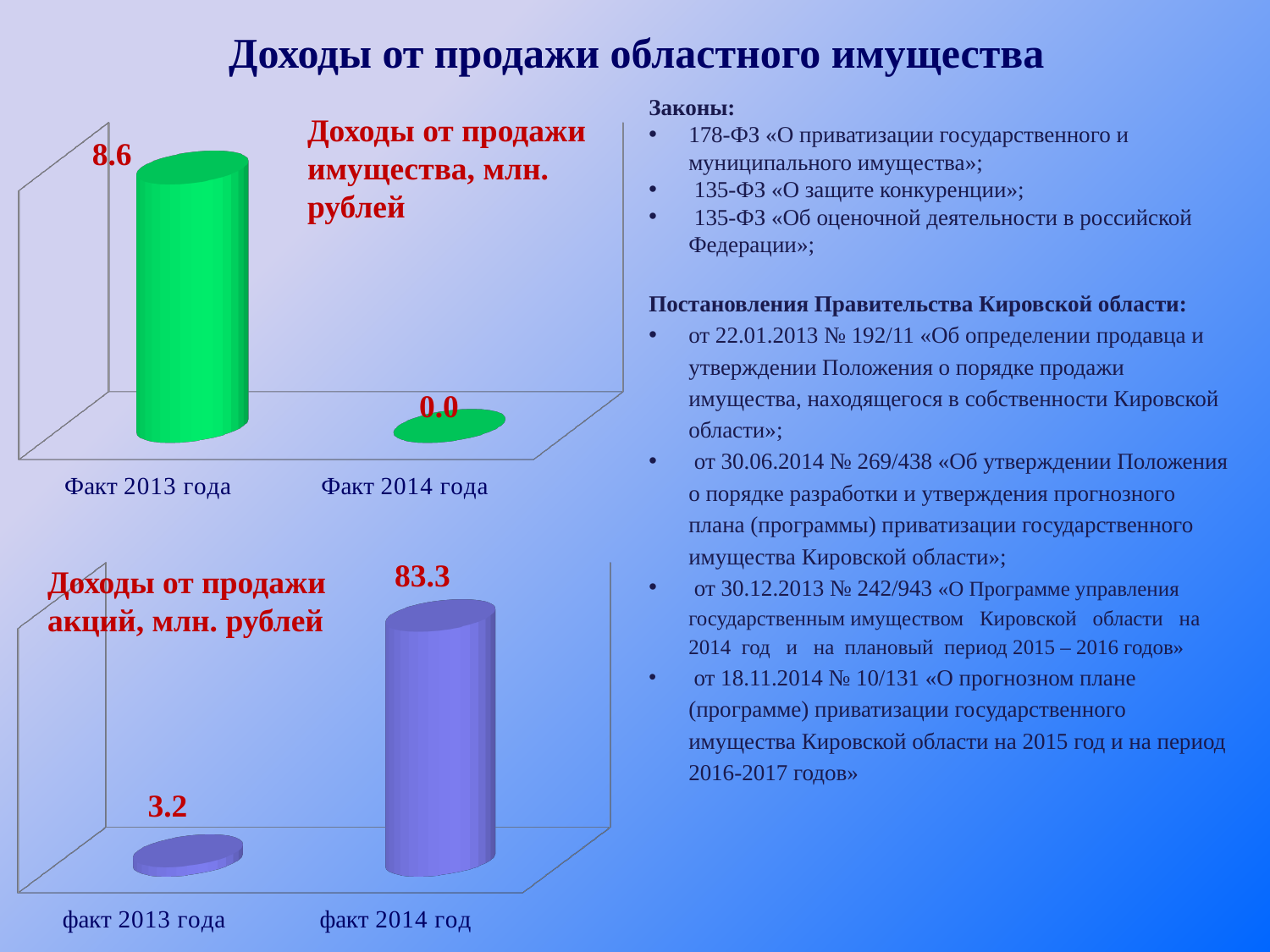
In the chart 'Доходы от продажи имущества, млн. рублей', what is the value for Факт 2014 года? 0.0 In the chart 'Доходы от продажи имущества, млн. рублей', which category has the highest value? Факт 2013 года In the chart 'Доходы от продажи имущества, млн. рублей', what is the value for Факт 2013 года? 8.6 In the chart 'Доходы от продажи акций, млн. рублей', do the values rise or fall from факт 2013 года to факт 2014 год? Rise What kind of chart is the bottom chart 'Доходы от продажи акций, млн. рублей'? Bar chart In the chart 'Доходы от продажи акций, млн. рублей', what is the value for факт 2013 года? 3.2 In the chart 'Доходы от продажи акций, млн. рублей', what is the difference between the values for факт 2014 год and факт 2013 года? 80.1 In the chart 'Доходы от продажи акций, млн. рублей', which is larger: the value for факт 2013 года or факт 2014 год? факт 2014 год In the chart 'Доходы от продажи акций, млн. рублей', which category has the lowest value? факт 2013 года How many categories are shown in the chart 'Доходы от продажи имущества, млн. рублей'? 2 In the chart 'Доходы от продажи акций, млн. рублей', what is the value for факт 2014 год? 83.3 In the chart 'Доходы от продажи имущества, млн. рублей', what is the difference between the values for Факт 2013 года and Факт 2014 года? 8.6